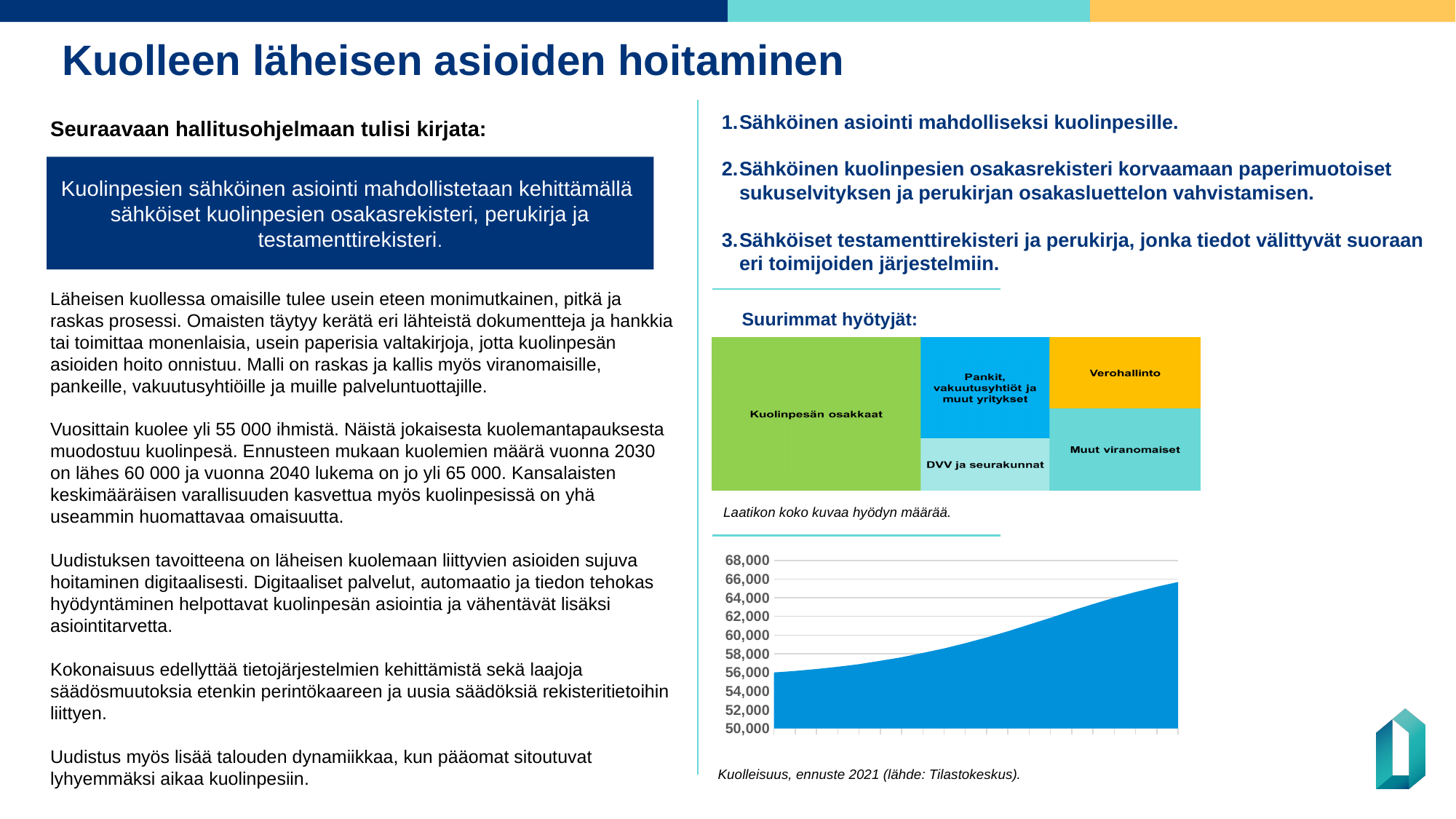
In the 'Suurimmat hyötyjät' chart, which box is larger: Verohallinto or Kuolinpesän osakkaat? Kuolinpesän osakkaat What kind of chart is the 'Suurimmat hyötyjät' chart? Treemap In the 'Suurimmat hyötyjät' chart, what colour is the Verohallinto box? Yellow In the bottom-right chart (Kuolleisuus, ennuste 2021), is the value at the left end of the series greater or less than 58,000? less In the 'Suurimmat hyötyjät' chart, which category occupies the smallest box? DVV ja seurakunnat In the bottom-right chart (Kuolleisuus, ennuste 2021), do the values rise or fall along the x axis? Rise What is the highest value shown on the y axis of the bottom-right chart (Kuolleisuus, ennuste 2021)? 68,000 In the 'Suurimmat hyötyjät' chart, which box is larger: Muut viranomaiset or DVV ja seurakunnat? Muut viranomaiset How many categories are shown in the 'Suurimmat hyötyjät' chart? 5 In the bottom-right chart (Kuolleisuus, ennuste 2021), is the value at the right end of the series greater or less than 64,000? greater What kind of chart is the chart at the bottom right of the slide (Kuolleisuus, ennuste 2021)? Area chart In the 'Suurimmat hyötyjät' chart, which category occupies the largest box? Kuolinpesän osakkaat